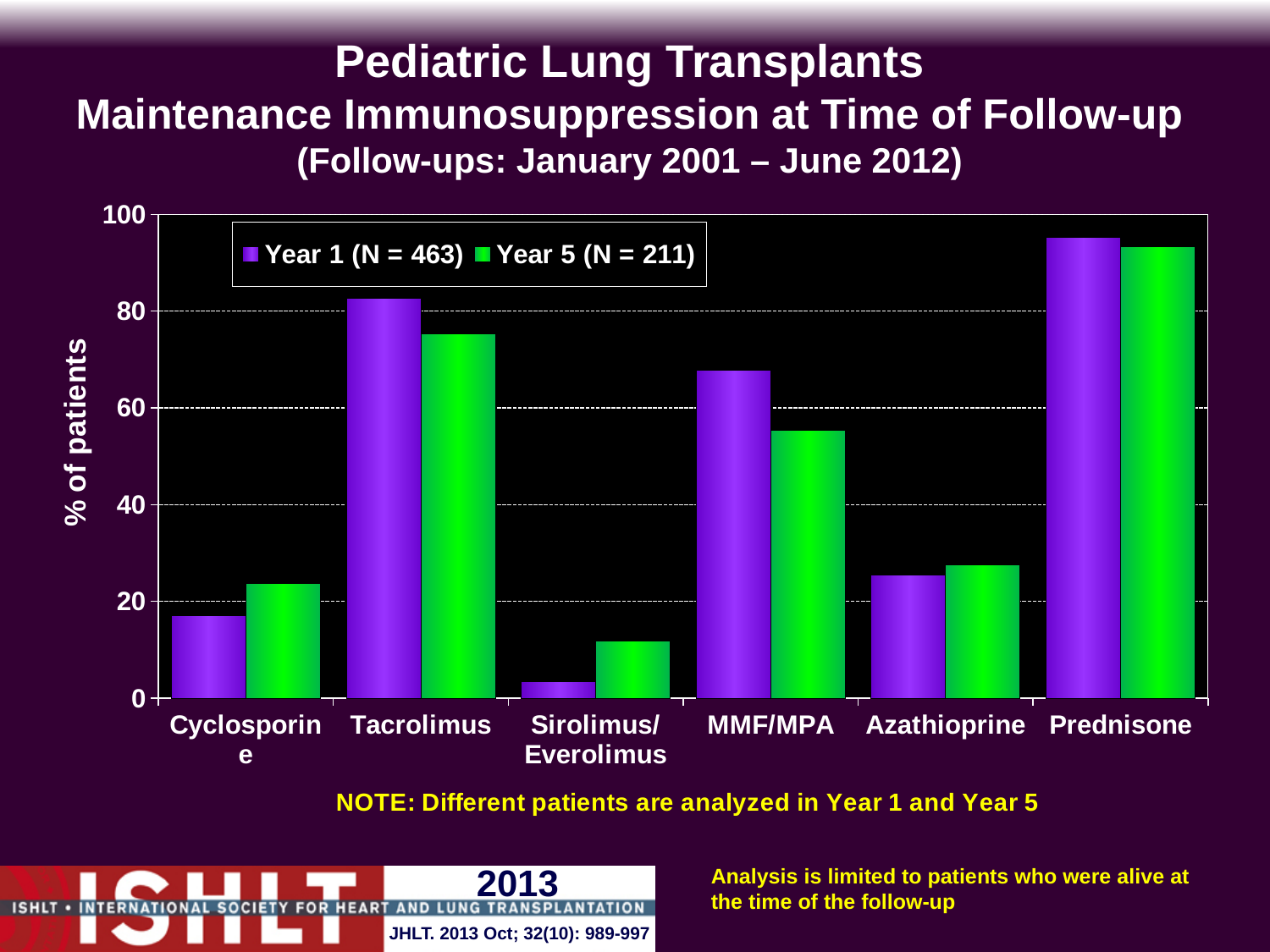
How many drug categories are shown on the x axis? 6 Which drug has the lowest Year 5 value? Sirolimus/Everolimus How many series does the legend list? 2 What kind of chart is shown on the slide? bar chart Is the Year 1 value for Tacrolimus greater or less than 80? greater Which drug has the highest Year 1 value? Prednisone What is the N given in the legend for Year 5? 211 Is the Year 1 value for Cyclosporine greater or less than 20? less For Tacrolimus, which is larger: the Year 1 value or the Year 5 value? Year 1 Which drug has the lowest Year 1 value? Sirolimus/Everolimus For Cyclosporine, which is larger: the Year 1 value or the Year 5 value? Year 5 Is the Year 5 value for MMF/MPA greater or less than 60? less